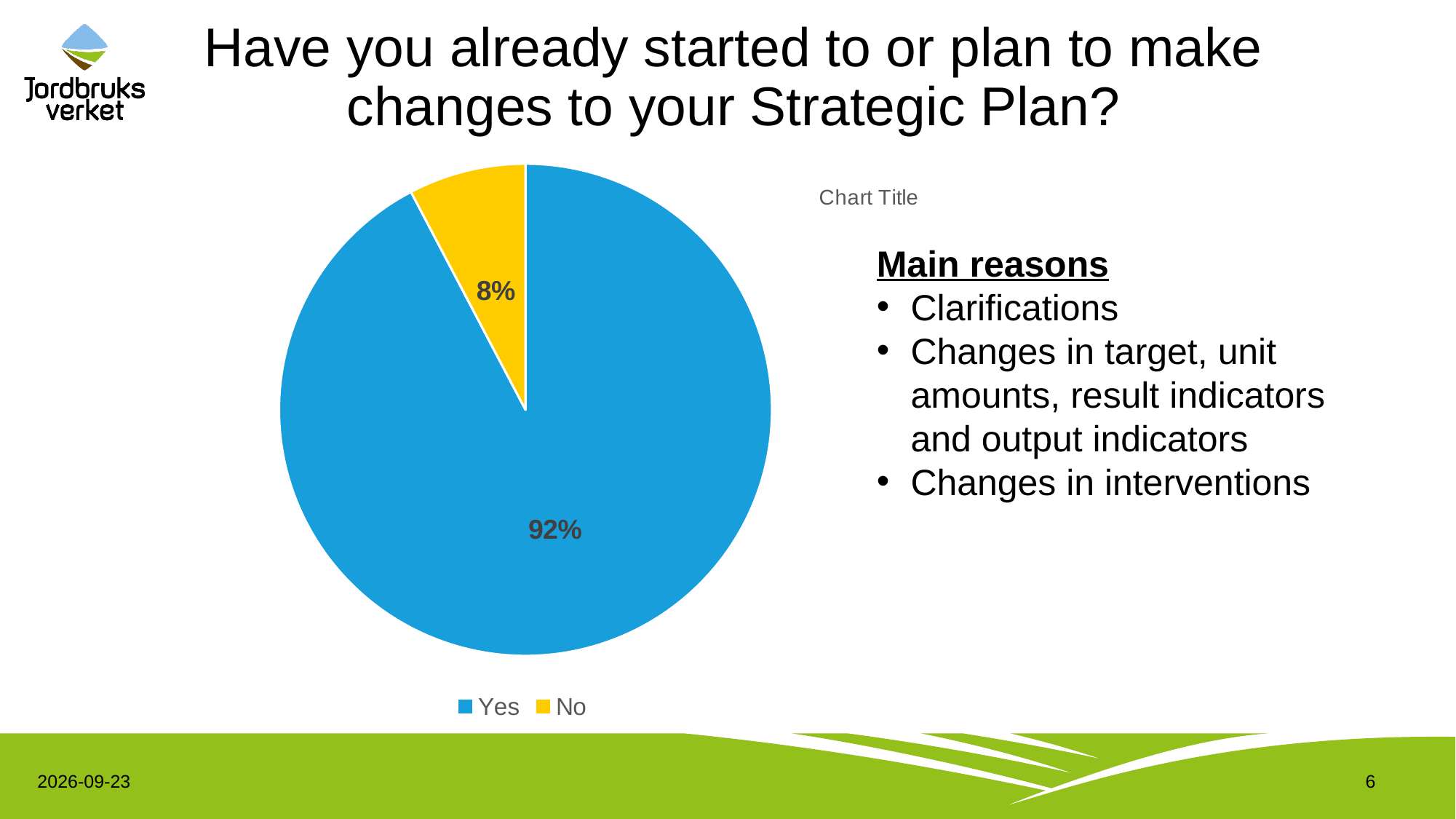
How many entries does the legend list? 2 Which slice is larger, Yes or No? Yes What colour is the No slice? yellow What colour is the Yes slice? blue What kind of chart is shown on the slide? pie chart What share of the pie does the Yes slice represent? 92% What is the difference in percentage points between the Yes and No slices? 84 How many slices does the pie chart have? 2 What share of the pie does the No slice represent? 8% Which category has the largest slice of the pie? Yes Which category has the smallest slice of the pie? No